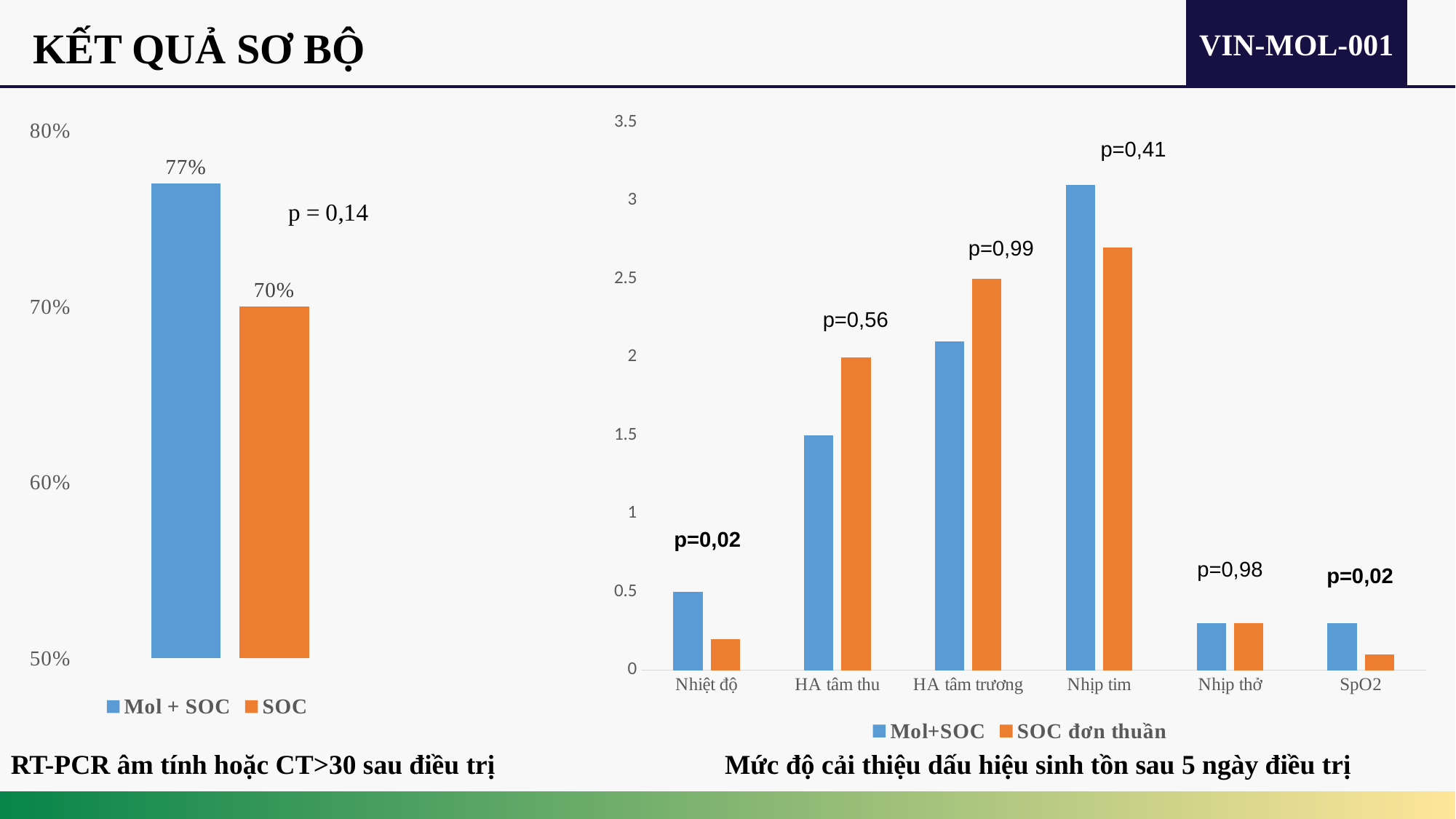
In the right chart (Mức độ cải thiện dấu hiệu sinh tồn sau 5 ngày điều trị), how many series does the legend list? 2 In the left chart (RT-PCR âm tính hoặc CT>30 sau điều trị), what is the value for SOC? 70% In the left chart (RT-PCR âm tính hoặc CT>30 sau điều trị), what is the difference between the Mol + SOC and SOC values? 7% In the right chart (Mức độ cải thiện dấu hiệu sinh tồn sau 5 ngày điều trị), how many categories are shown on the x axis? 6 In the right chart (Mức độ cải thiện dấu hiệu sinh tồn sau 5 ngày điều trị), for HA tâm thu, which series has the larger value, Mol+SOC or SOC đơn thuần? SOC đơn thuần In the left chart (RT-PCR âm tính hoặc CT>30 sau điều trị), which group has the larger value, Mol + SOC or SOC? Mol + SOC In the right chart (Mức độ cải thiện dấu hiệu sinh tồn sau 5 ngày điều trị), is the Mol+SOC value for Nhịp tim greater or less than 2.5? greater In the right chart (Mức độ cải thiện dấu hiệu sinh tồn sau 5 ngày điều trị), which category has the lowest SOC đơn thuần value? SpO2 In the left chart (RT-PCR âm tính hoặc CT>30 sau điều trị), what is the value for Mol + SOC? 77% In the right chart (Mức độ cải thiện dấu hiệu sinh tồn sau 5 ngày điều trị), which category has the highest Mol+SOC value? Nhịp tim In the left chart (RT-PCR âm tính hoặc CT>30 sau điều trị), what p-value is printed on the chart? p = 0,14 What kind of chart is the right chart (Mức độ cải thiện dấu hiệu sinh tồn sau 5 ngày điều trị)? Bar chart